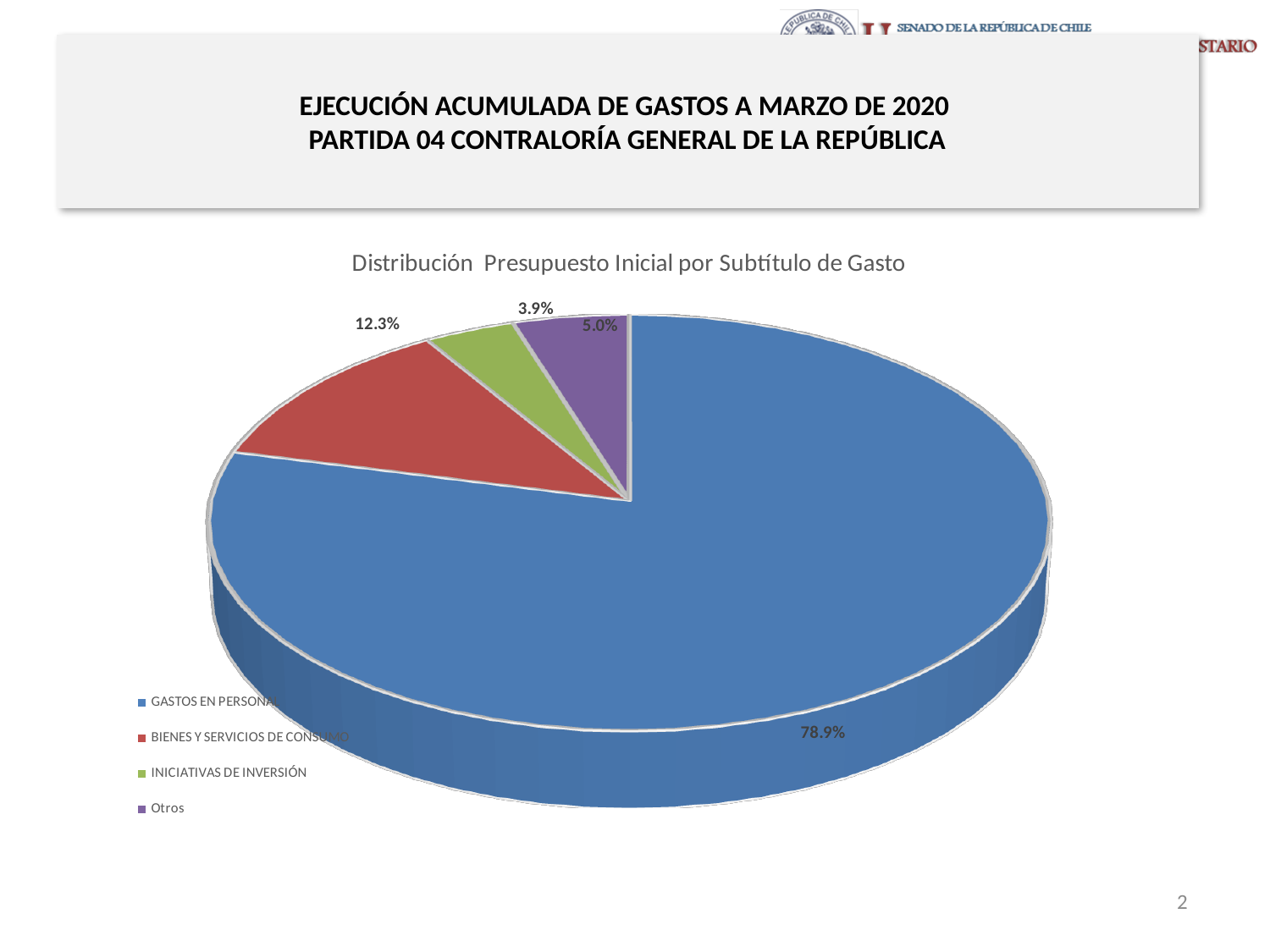
Which category has the smallest slice of the pie? INICIATIVAS DE INVERSIÓN What share of the pie does INICIATIVAS DE INVERSIÓN represent? 3.9% How many categories does the pie chart show? 4 What is the title of the chart? Distribución Presupuesto Inicial por Subtítulo de Gasto What kind of chart is shown on the slide? pie chart What share of the pie does BIENES Y SERVICIOS DE CONSUMO represent? 12.3% What share of the pie does Otros represent? 5.0% Which category has the largest slice of the pie? GASTOS EN PERSONAL What colour is the slice for Otros? purple Which is larger, the share for Otros or the share for INICIATIVAS DE INVERSIÓN? Otros What is the difference in percentage points between the GASTOS EN PERSONAL share and the BIENES Y SERVICIOS DE CONSUMO share? 66.6